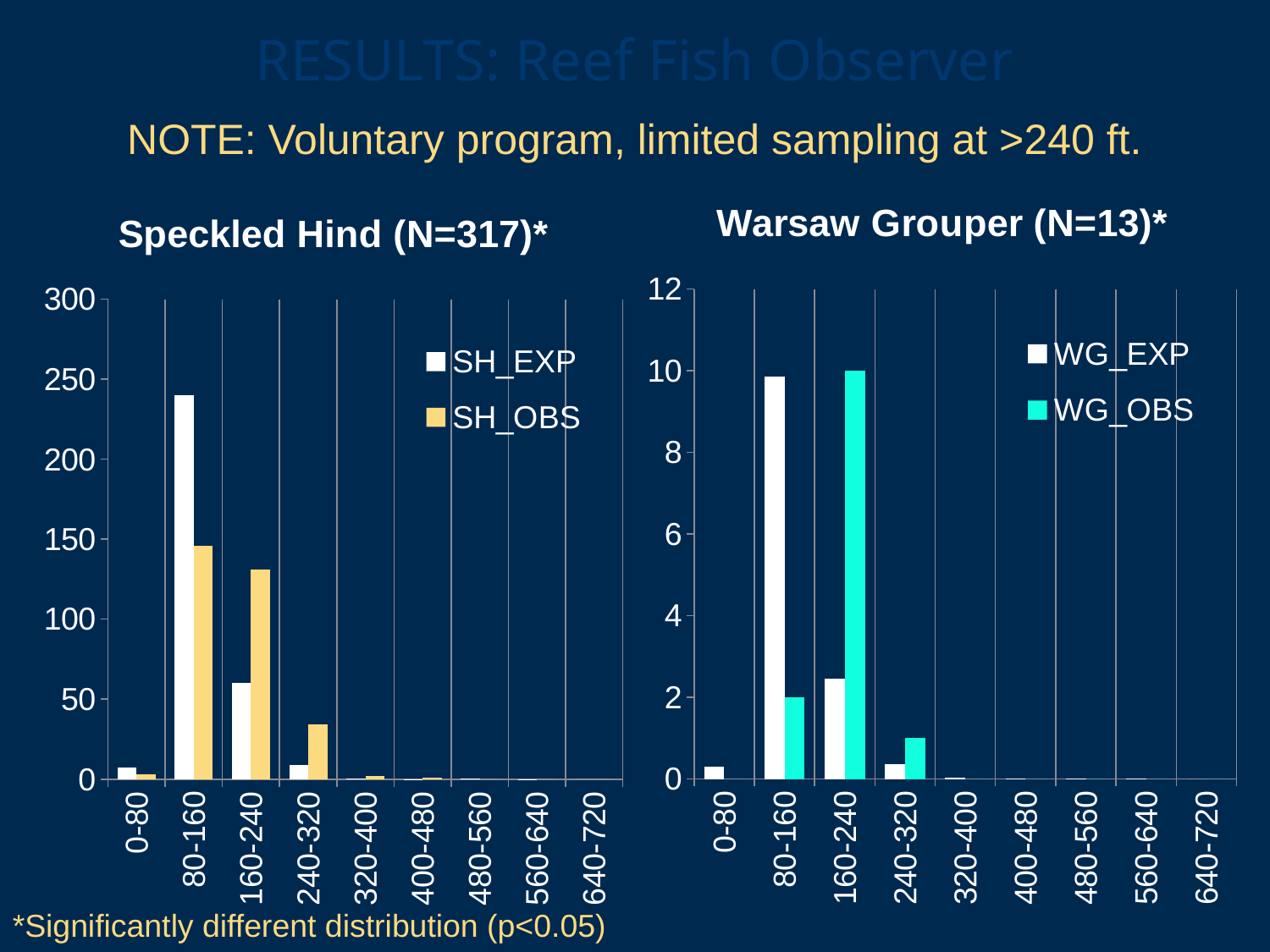
On the Warsaw Grouper (N=13)* chart, is the WG_EXP value for 80-160 greater or less than 8? greater On the Warsaw Grouper (N=13)* chart, what are the two legend entries? WG_EXP and WG_OBS On the Warsaw Grouper (N=13)* chart, how many depth categories are shown on the x axis? 9 On the Speckled Hind (N=317)* chart, for the 160-240 category, which is larger: SH_EXP or SH_OBS? SH_OBS On the Speckled Hind (N=317)* chart, is the SH_OBS value for 160-240 greater or less than 100? greater On the Speckled Hind (N=317)* chart, which depth category has the highest SH_EXP value? 80-160 On the Speckled Hind (N=317)* chart, is the SH_OBS value for 240-320 greater or less than 50? less On the Speckled Hind (N=317)* chart, what kind of chart is shown? bar chart On the Warsaw Grouper (N=13)* chart, for the 80-160 category, which is larger: WG_EXP or WG_OBS? WG_EXP On the Speckled Hind (N=317)* chart, how many series does the legend list? 2 On the Warsaw Grouper (N=13)* chart, which depth category has the highest WG_OBS value? 160-240